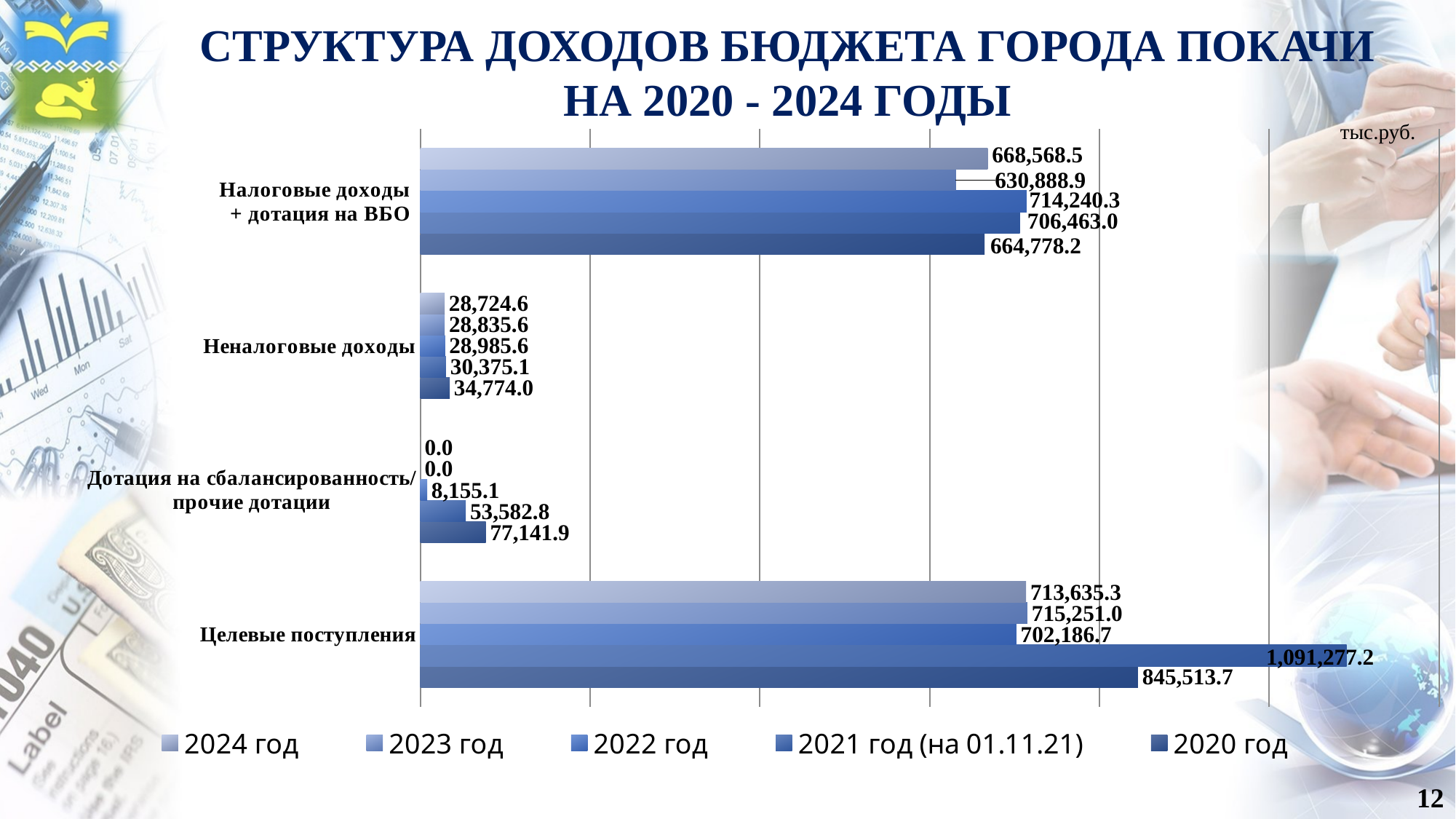
Which year has the highest value for Целевые поступления? 2021 год (на 01.11.21) How many series does the legend list? 5 What is the value of Целевые поступления for 2021 год (на 01.11.21)? 1,091,277.2 What is the value of Дотация на сбалансированность/прочие дотации for 2022 год? 8,155.1 What type of chart is shown on the slide? bar chart How many categories are shown on the chart? 4 What is the value of Неналоговые доходы for 2020 год? 34,774.0 What is the value of Налоговые доходы + дотация на ВБО for 2023 год? 630,888.9 What unit of measurement is indicated in the top right corner of the chart? тыс.руб. Which is larger for 2022 год: Налоговые доходы + дотация на ВБО or Целевые поступления? Налоговые доходы + дотация на ВБО What is the difference between the 2020 год and 2021 год (на 01.11.21) values for Дотация на сбалансированность/прочие дотации? 23,559.1 Which year has the lowest value for Налоговые доходы + дотация на ВБО? 2023 год